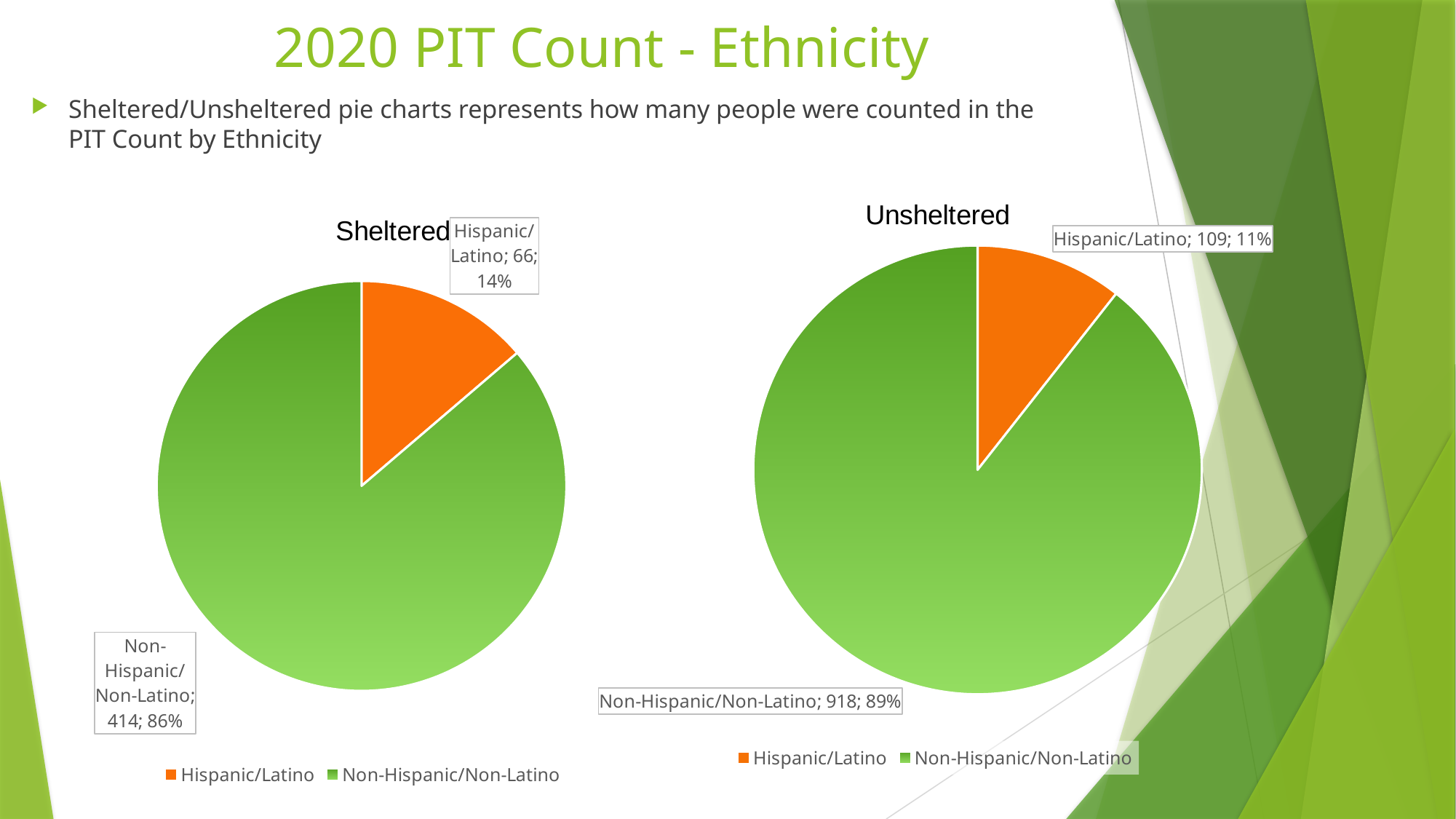
In the Unsheltered pie chart, how many people were counted as Hispanic/Latino? 109 In the Sheltered pie chart, what share of the pie is Hispanic/Latino? 14% In the Unsheltered pie chart, what share of the pie is Non-Hispanic/Non-Latino? 89% Which is larger: the Hispanic/Latino count in the Sheltered chart or the Hispanic/Latino count in the Unsheltered chart? Unsheltered In the Unsheltered pie chart, how many people were counted as Non-Hispanic/Non-Latino? 918 How many entries does the legend of the Sheltered chart list? 2 In the Unsheltered pie chart, which category is the largest? Non-Hispanic/Non-Latino In the Sheltered pie chart, how many people were counted as Hispanic/Latino? 66 In the Sheltered pie chart, which category is the smallest? Hispanic/Latino In the Sheltered pie chart, how many people were counted as Non-Hispanic/Non-Latino? 414 In the Sheltered pie chart, what is the difference between the Non-Hispanic/Non-Latino count and the Hispanic/Latino count? 348 What type of chart is the Unsheltered chart? Pie chart